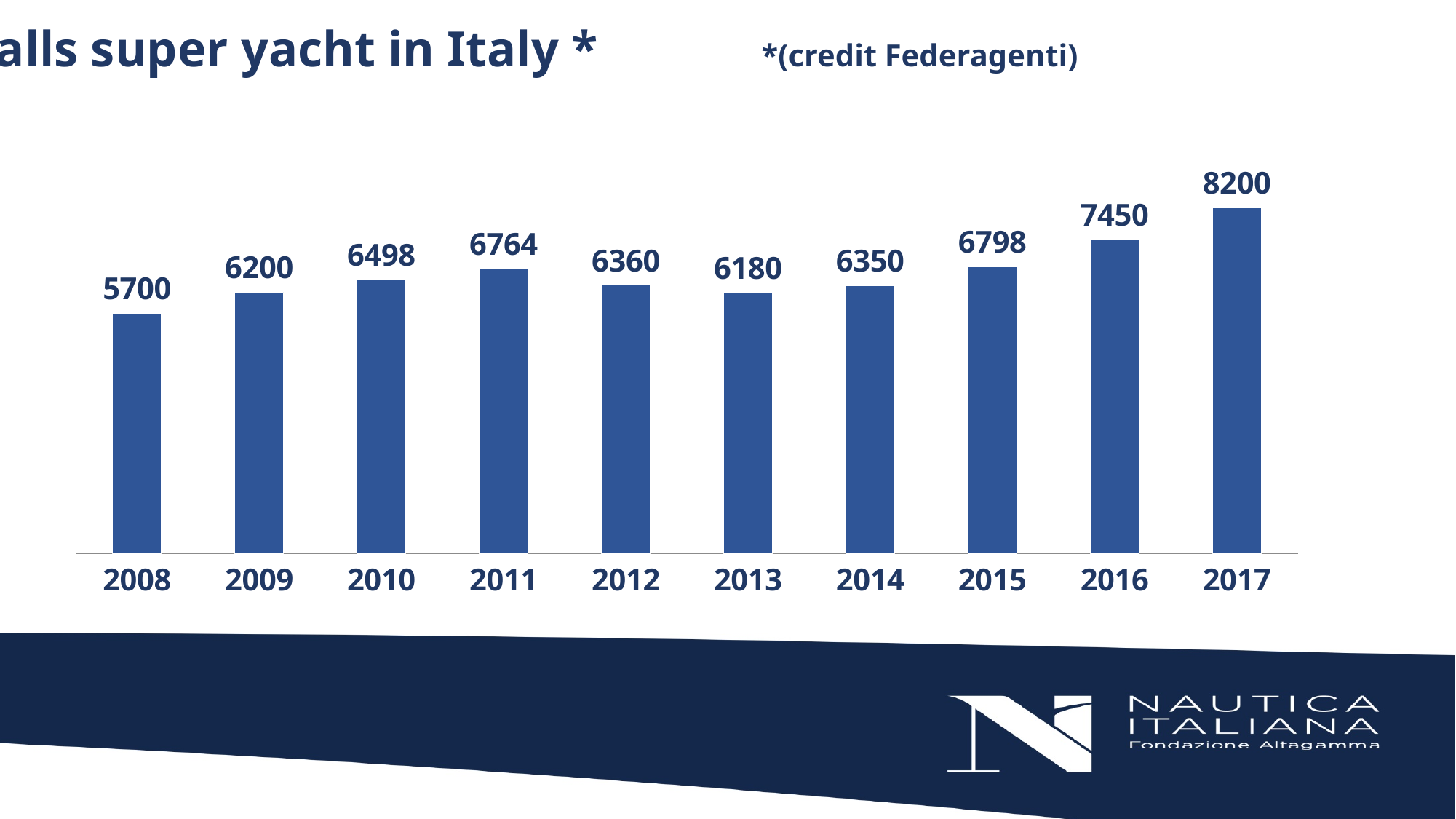
Which year has the lowest value? 2008 What is the value for 2013? 6180 What kind of chart is shown on the slide? bar chart Which is larger, the value for 2010 or the value for 2014? 2010 What is the value for 2008? 5700 What is the value for 2016? 7450 What is the difference between the values for 2017 and 2016? 750 Which is larger, the value for 2011 or the value for 2015? 2015 Do the values rise or fall from 2014 to 2017? rise How many years are shown on the x axis? 10 What is the difference between the values for 2011 and 2012? 404 Which year has the highest value? 2017